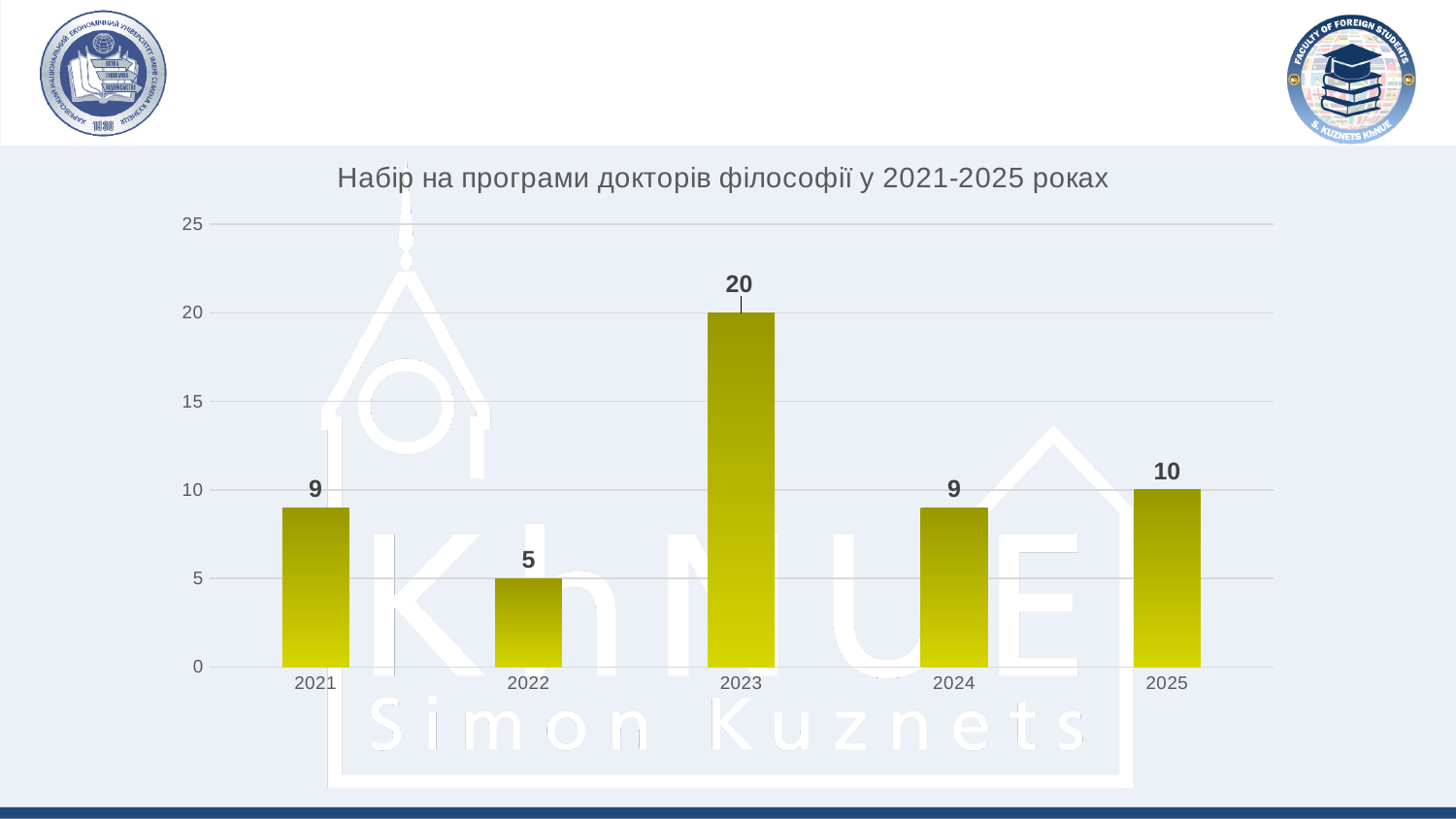
What is the difference between the values for 2023 and 2022? 15 What kind of chart is shown on the slide? bar chart Which is larger, the value for 2021 or the value for 2022? 2021 Which year has the lowest value? 2022 Which year has the highest value? 2023 What is the difference between the values for 2025 and 2024? 1 Is the value for 2023 greater or less than 15? greater How many years are shown on the x axis? 5 What is the title of the chart? Набір на програми докторів філософії у 2021-2025 роках What is the value for 2023? 20 What is the value for 2022? 5 What is the value for 2025? 10